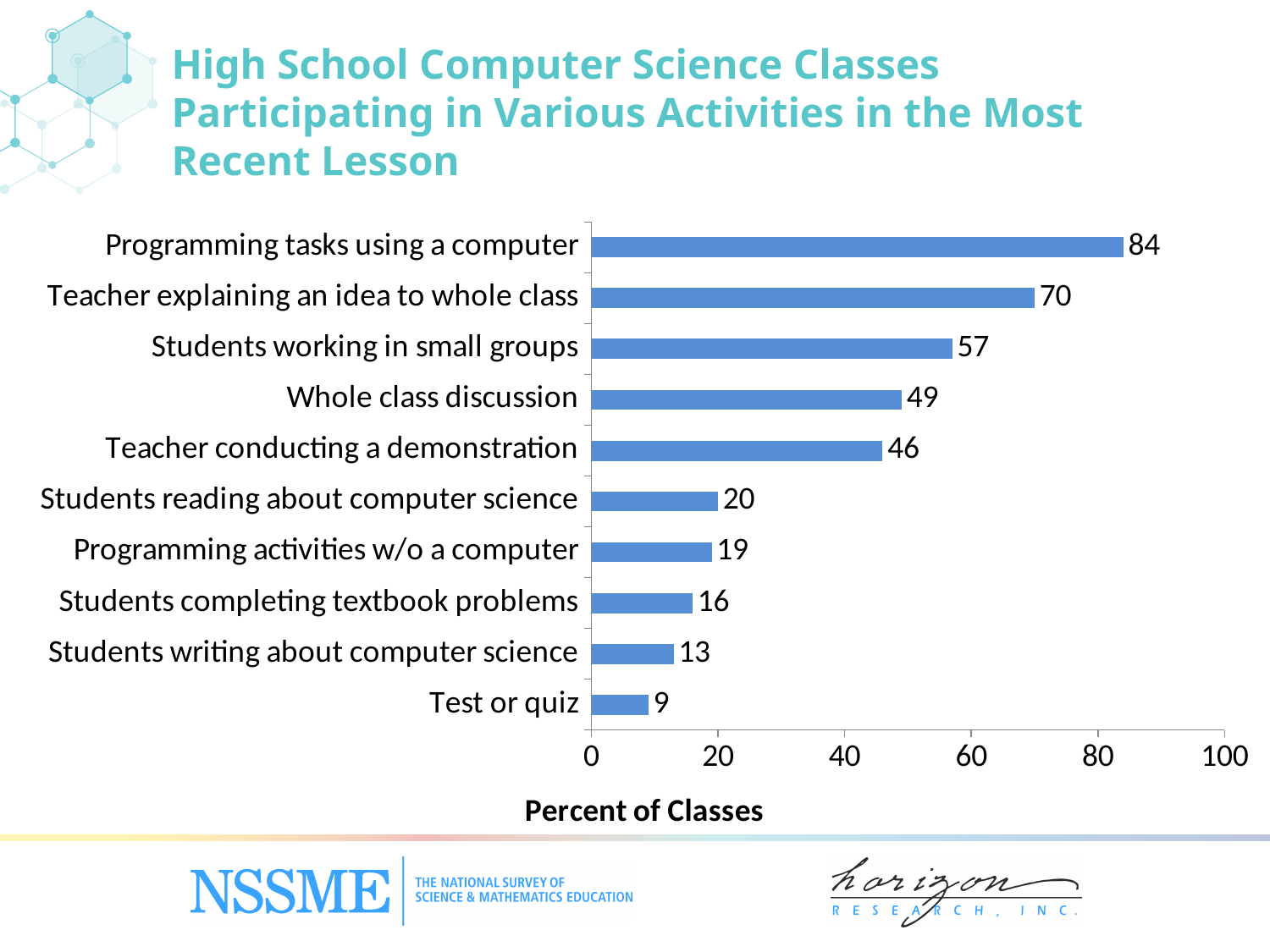
What is the difference between 'Programming tasks using a computer' and 'Test or quiz'? 75 Which activity has the highest percent of classes? Programming tasks using a computer Which activity has the lowest percent of classes? Test or quiz What percent of classes had programming tasks using a computer in the most recent lesson? 84 What is the value for 'Students writing about computer science'? 13 Which is larger: 'Teacher conducting a demonstration' or 'Students reading about computer science'? Teacher conducting a demonstration What kind of chart is shown on the slide? Bar chart What is the value for 'Whole class discussion'? 49 What is the difference between 'Teacher explaining an idea to whole class' and 'Students working in small groups'? 13 Is the value for 'Students completing textbook problems' greater or less than 20? less How many activities are shown in the chart? 10 What is the label of the horizontal axis? Percent of Classes